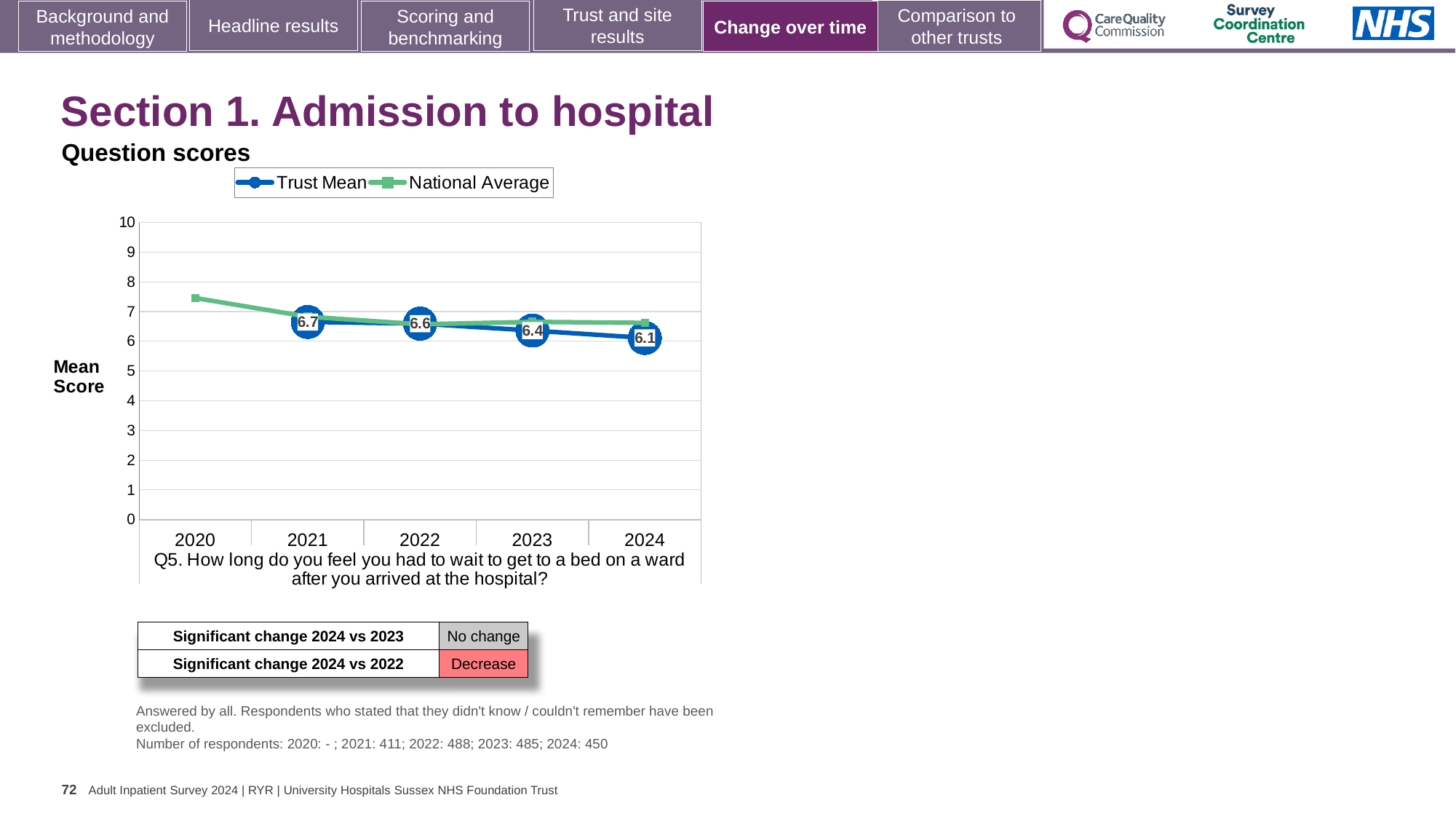
In which year is the Trust Mean score highest? 2021 How many series does the legend list? 2 Which is larger, the Trust Mean score for 2022 or for 2024? 2022 How many years are shown on the x axis? 5 What is the Trust Mean score for 2023? 6.4 What is the Trust Mean score for 2024? 6.1 Is the National Average value for 2020 greater or less than 7? greater Does the Trust Mean score rise or fall from 2021 to 2024? Fall What kind of chart is shown? Line chart What is the difference between the Trust Mean scores for 2021 and 2024? 0.6 In which year is the Trust Mean score lowest? 2024 What is the Trust Mean score for 2021? 6.7